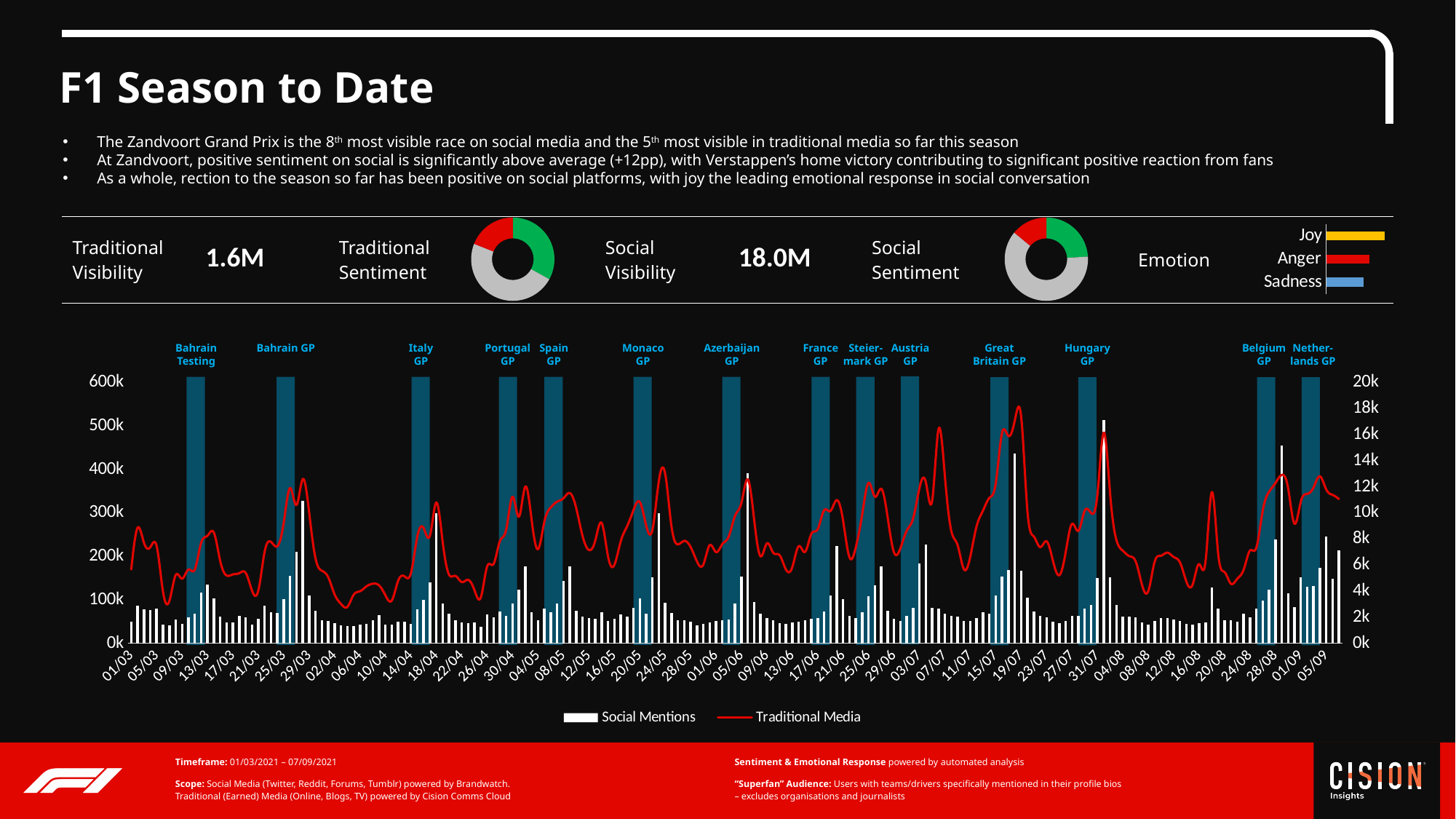
In the main chart at the bottom, which series is drawn as a red line? Traditional Media In the main chart at the bottom, is the peak of the Traditional Media line (around 19/07) greater or less than 16k on the right axis? greater How many emotions are listed in the Emotion chart? 3 In the main chart at the bottom, what are the two series named in the legend? Social Mentions and Traditional Media In the main chart at the bottom, what is the highest tick on the right-hand axis? 20k In the main chart at the bottom, how many race events are labelled above the highlighted columns? 14 In the main chart at the bottom, what is the highest tick on the left-hand axis? 600k In the main chart at the bottom, how many series does the legend list? 2 What kind of chart is the Traditional Sentiment chart? Donut (pie) chart In the main chart at the bottom, is the tallest Social Mentions bar (around the Hungary GP) greater or less than 400k on the left axis? greater In the Emotion chart, which emotion has the longest bar? Joy In the Emotion chart, which emotion has the shortest bar? Sadness